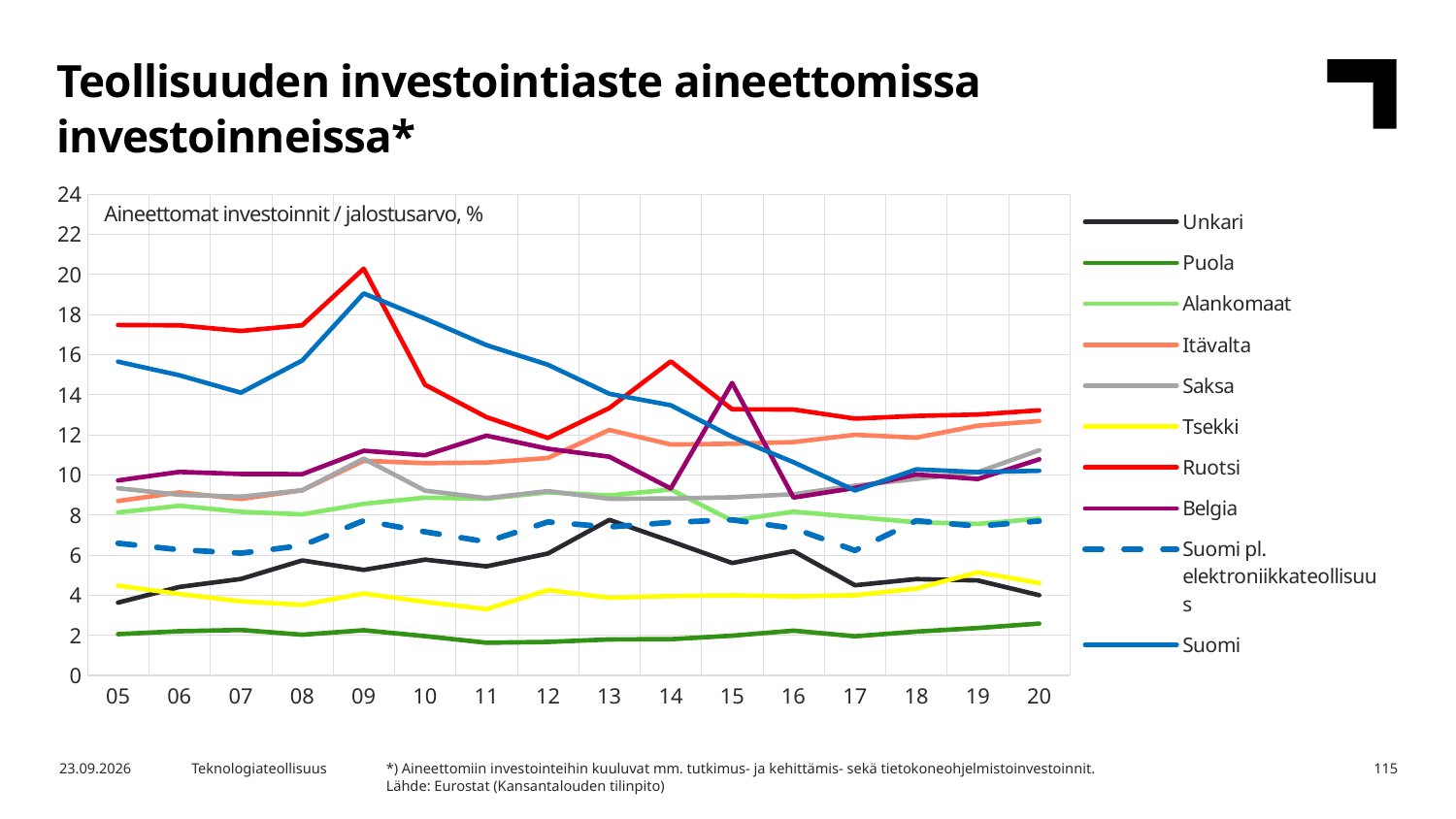
Which series has the lowest value in 20? Puola Which is larger in 20, the value for Tsekki or the value for Puola? Tsekki Which series has the highest value in 15? Belgia What kind of chart is shown on the slide? line chart How many years are shown on the x axis? 16 Is the value for Puola in 11 greater or less than 2? less Does the value for Suomi rise or fall from 09 to 17? fall Is the value for Suomi in 09 greater or less than 18? greater Is the value for Ruotsi in 05 greater or less than 16? greater How many series does the legend list? 10 Which series is drawn with a dashed line? Suomi pl. elektroniikkateollisuus Which series has the highest value in 05? Ruotsi